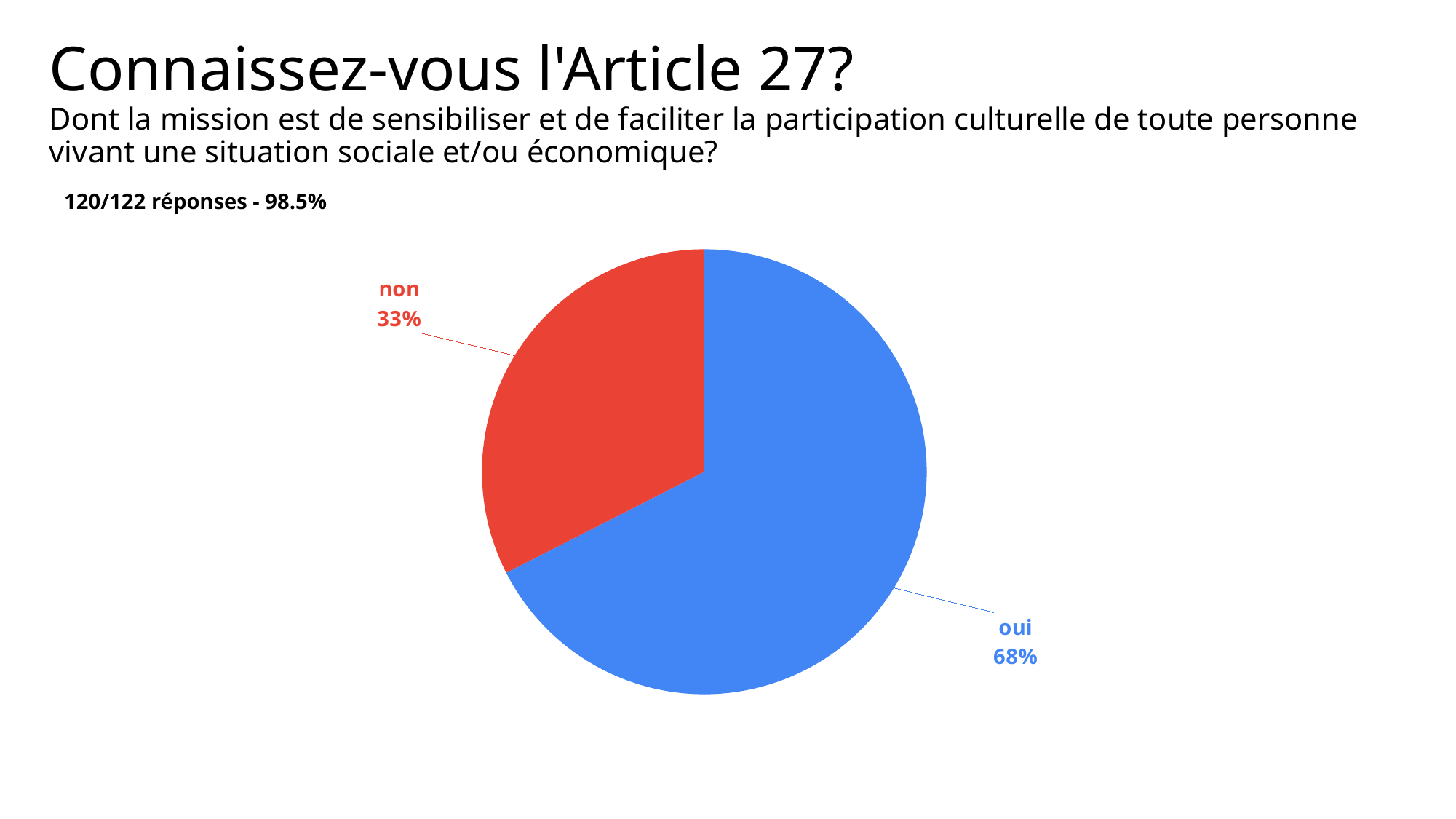
What kind of chart is shown on the slide? pie chart What percentage of respondents answered "oui"? 68% What share of the pie does the "non" slice represent? 33% What percentage of respondents answered "non"? 33% What is the difference in percentage points between the "oui" and "non" slices? 35 How many responses does the slide say were collected? 120/122 réponses - 98.5% What colour is the "oui" slice? blue Which slice of the pie is the largest? oui Which slice of the pie is the smallest? non How many slices does the pie chart have? 2 Which is larger, the "oui" slice or the "non" slice? oui